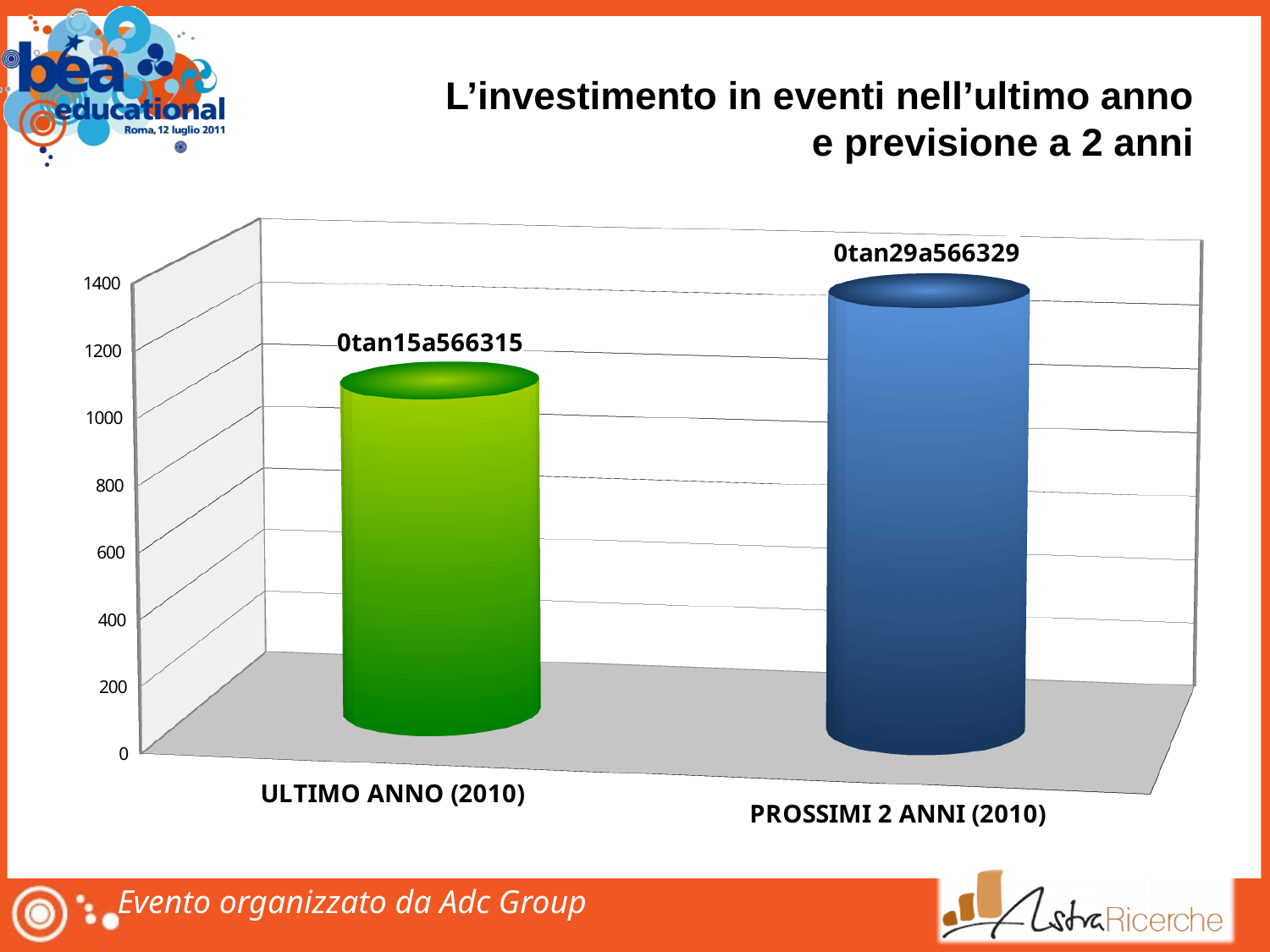
What is the title of the chart on the slide? L'investimento in eventi nell'ultimo anno e previsione a 2 anni What is the highest value shown on the vertical axis of the chart? 1400 How many categories are plotted in the chart? 2 Which category has the lowest value in the chart? ULTIMO ANNO (2010) What colour is the bar for PROSSIMI 2 ANNI (2010)? blue Do the values rise or fall from ULTIMO ANNO (2010) to PROSSIMI 2 ANNI (2010)? rise Is the value for ULTIMO ANNO (2010) greater or less than 800? greater What kind of chart is shown on the slide? bar chart Is the value for ULTIMO ANNO (2010) greater or less than 1400? less Which category has the highest value in the chart? PROSSIMI 2 ANNI (2010) Is the value for PROSSIMI 2 ANNI (2010) greater or less than 1000? greater Which is larger, the value for ULTIMO ANNO (2010) or the value for PROSSIMI 2 ANNI (2010)? PROSSIMI 2 ANNI (2010)